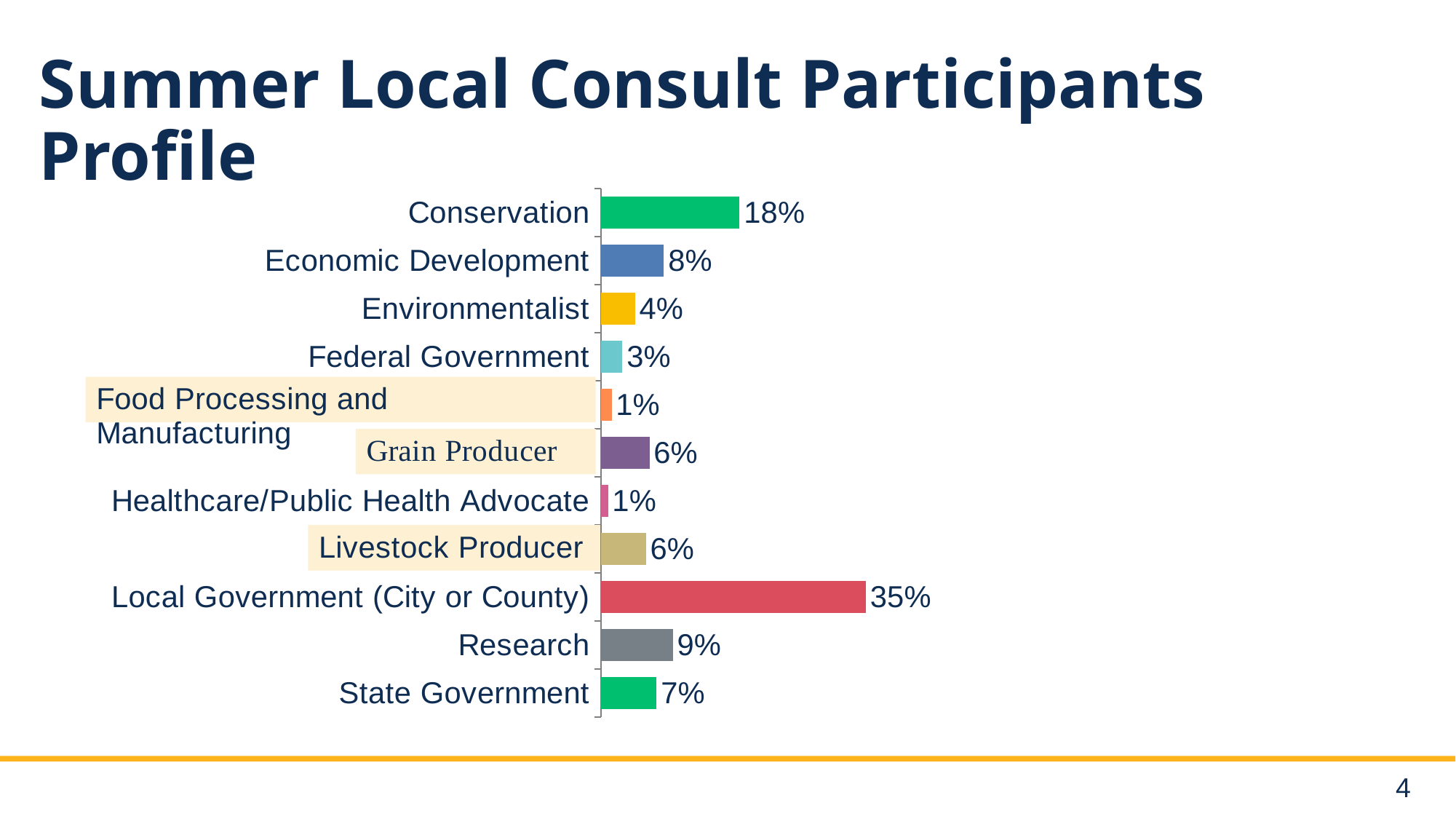
What percentage is shown for Research? 9% Which is larger, the value for Research or the value for State Government? Research What is the value shown for Conservation? 18% What is the value for Federal Government? 3% Which is larger, Economic Development or Grain Producer? Economic Development What kind of chart is shown on the slide? Bar chart What is the title of the slide containing the chart? Summer Local Consult Participants Profile How many categories are shown in the chart? 11 What is the difference between the Local Government (City or County) value and the Conservation value? 17% What percentage of participants are from Local Government (City or County)? 35% Which category has the highest percentage? Local Government (City or County) What is the difference between Economic Development and Environmentalist? 4%